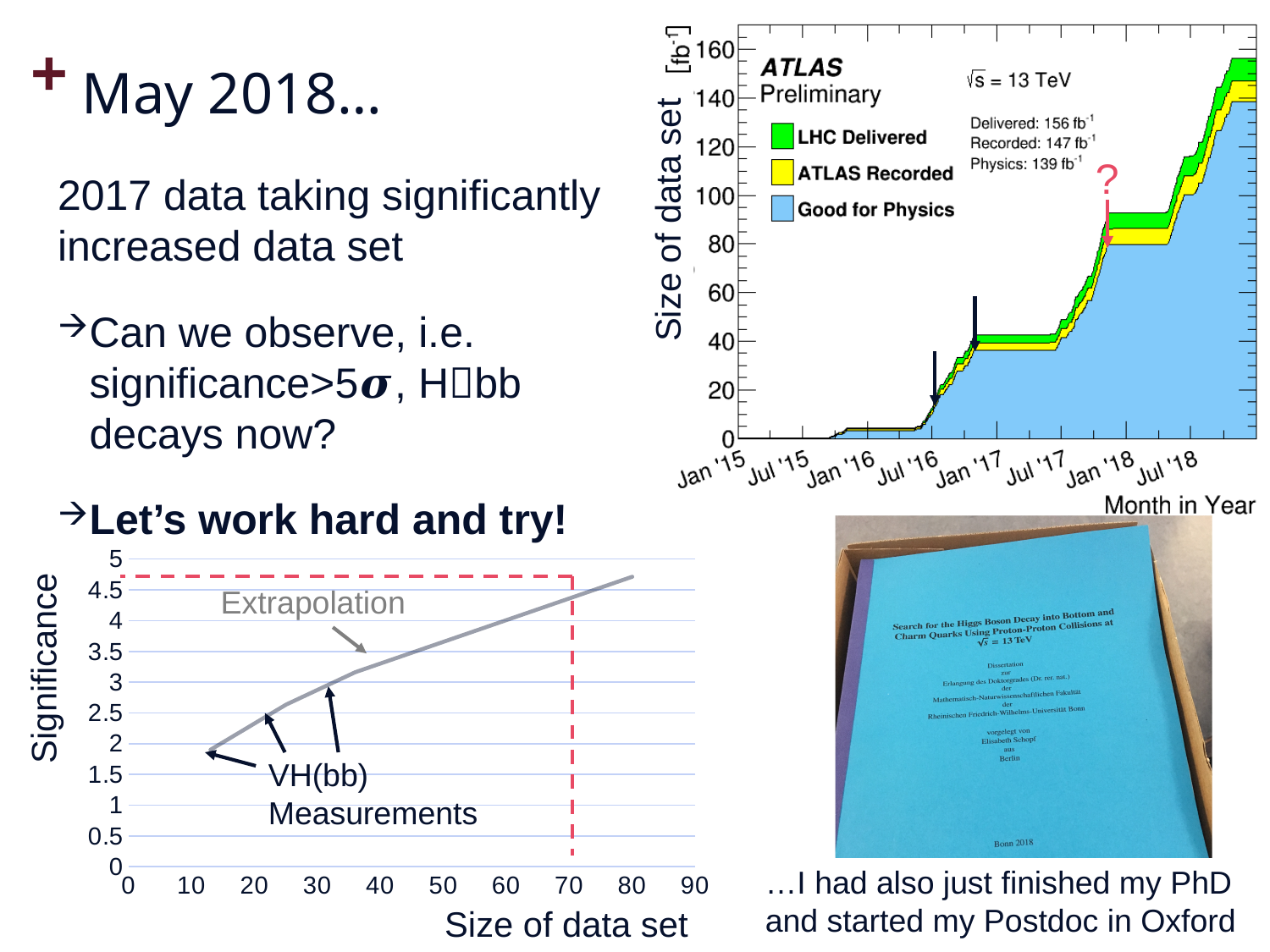
In the Significance chart at the bottom left, what kind of chart is it? line chart In the Significance chart at the bottom left, is the significance at a data set size of 70 greater or less than 5? less In the ATLAS chart at the top right, which legend entry is shown in yellow? ATLAS Recorded In the ATLAS chart at the top right, what is the difference between the delivered and recorded luminosity values given in the annotation? 9 fb⁻¹ In the Significance chart at the bottom left, what is the highest value shown on the y axis? 5 In the ATLAS chart at the top right, how many entries does the legend list? 3 In the Significance chart at the bottom left, does the significance rise or fall as the size of the data set increases? rise In the ATLAS chart at the top right, what is the label of the x axis? Month in Year In the ATLAS chart at the top right, what is the recorded integrated luminosity stated in the annotation? 147 fb⁻¹ In the ATLAS chart at the top right, does the size of the data set rise or fall over time along the x axis? rise In the ATLAS chart at the top right, what is the delivered integrated luminosity stated in the annotation? 156 fb⁻¹ In the ATLAS chart at the top right, what is the 'Physics' integrated luminosity stated in the annotation? 139 fb⁻¹